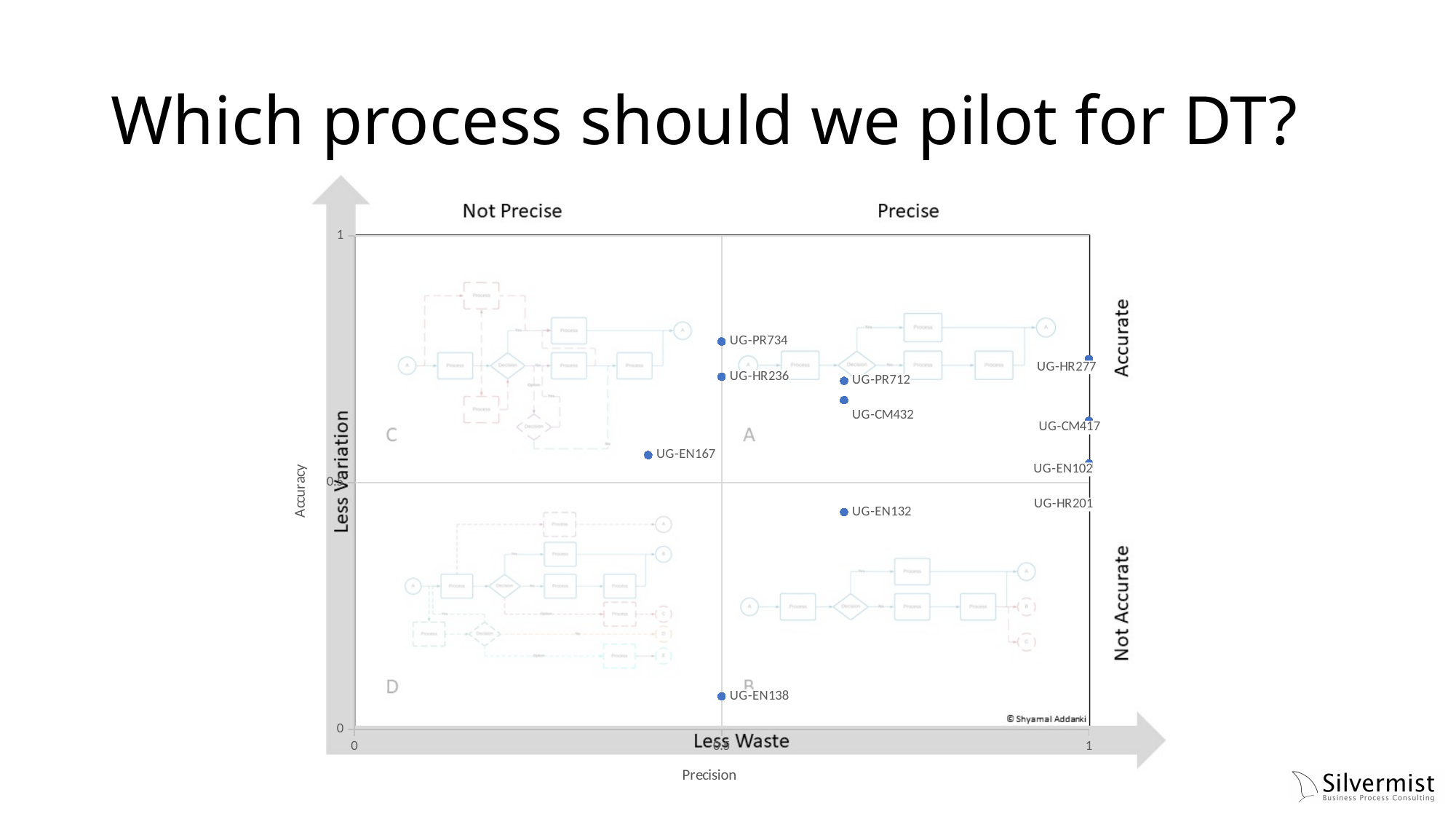
What is the label of the vertical axis of the chart? Accuracy Which has the higher accuracy value, UG-EN138 or UG-EN132? UG-EN132 What kind of chart is shown on the slide? scatter chart Is the precision value for UG-EN167 greater or less than 0.5? less Which process has the lowest accuracy value on the chart? UG-EN138 Is the accuracy value for UG-EN138 greater or less than 0.5? less What is the label of the horizontal axis of the chart? Precision Is the accuracy value for UG-PR734 greater or less than 0.5? greater Which has the higher accuracy value, UG-PR734 or UG-EN167? UG-PR734 How many labeled data points are plotted on the chart? 11